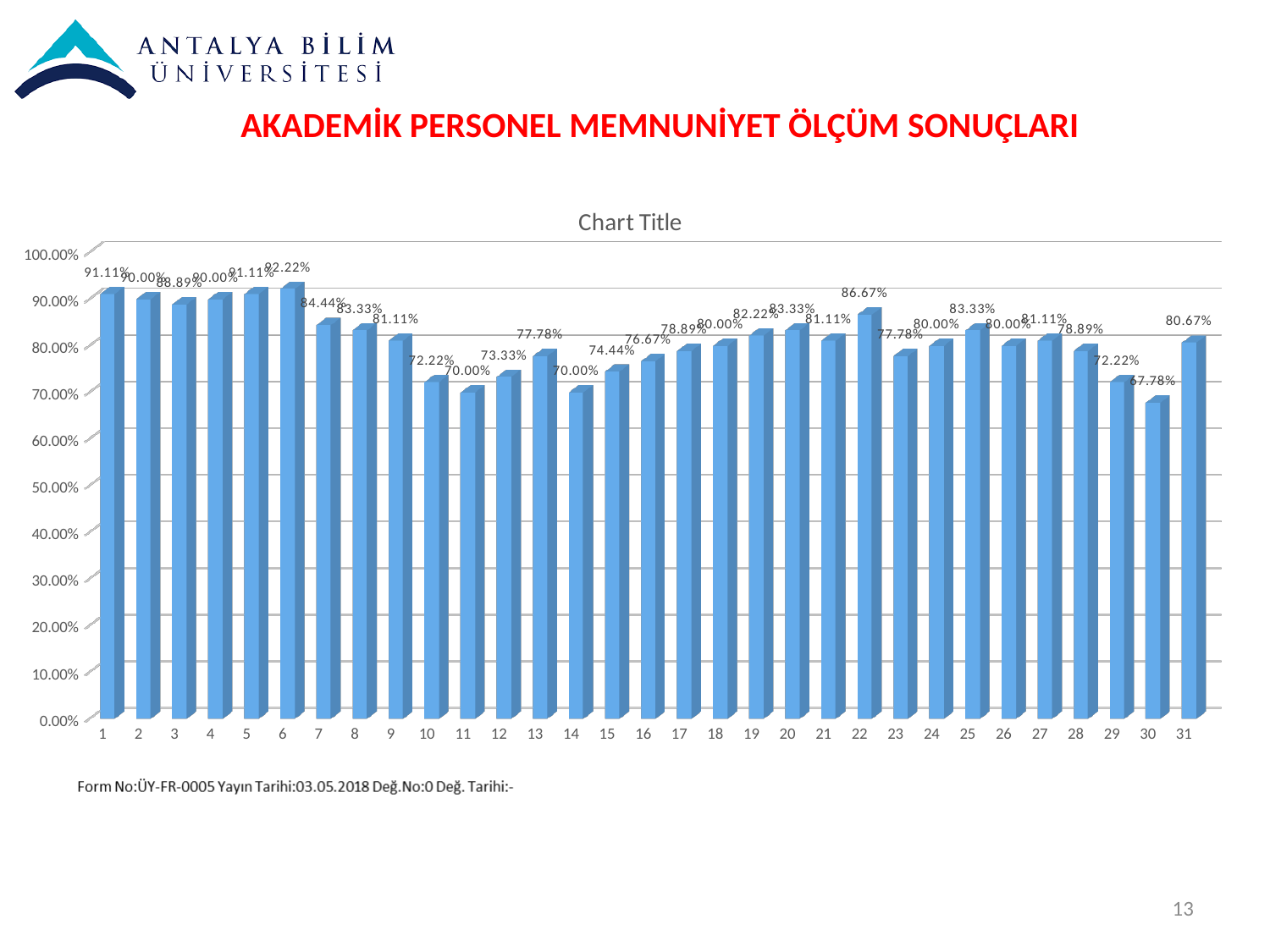
What is the difference between the values for category 22 and category 23? 8.89% What kind of chart is shown on the slide? bar chart Is the value for category 14 greater or less than 80.00%? less What is the value for category 6? 92.22% What is the title shown above the chart? Chart Title Which category has the highest value? 6 What is the value for category 30? 67.78% Which category has the lowest value? 30 What is the value for category 31? 80.67% Which is larger, the value for category 9 or the value for category 10? category 9 What is the value for category 22? 86.67% How many categories are plotted on the x axis of the chart? 31